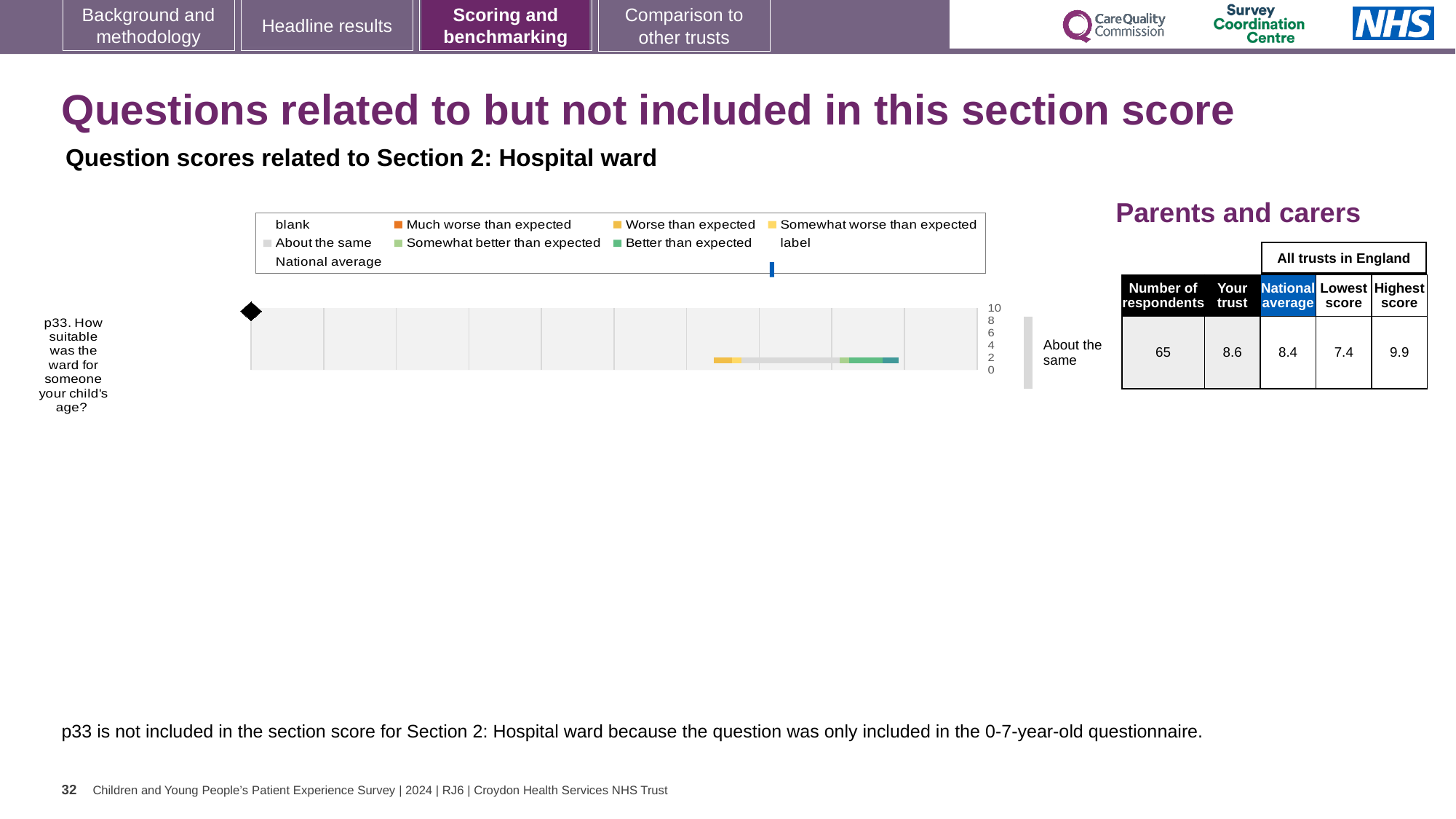
Which question is plotted in the chart? p33. How suitable was the ward for someone your child's age? What is the difference between the highest and lowest scores for p33? 2.5 What benchmark label is shown to the right of the bar for p33? About the same What is the difference between the 'Your trust' score and the national average for p33? 0.2 Which is larger for p33, the 'Your trust' score or the national average? Your trust What is the highest score among all trusts in England for p33? 9.9 What is the lowest score among all trusts in England for p33? 7.4 How many questions are plotted in the chart? 1 What kind of chart is shown on the slide? bar chart What is the 'Your trust' score for p33 in the table? 8.6 How many respondents answered p33? 65 What is the national average score for p33 in the table? 8.4